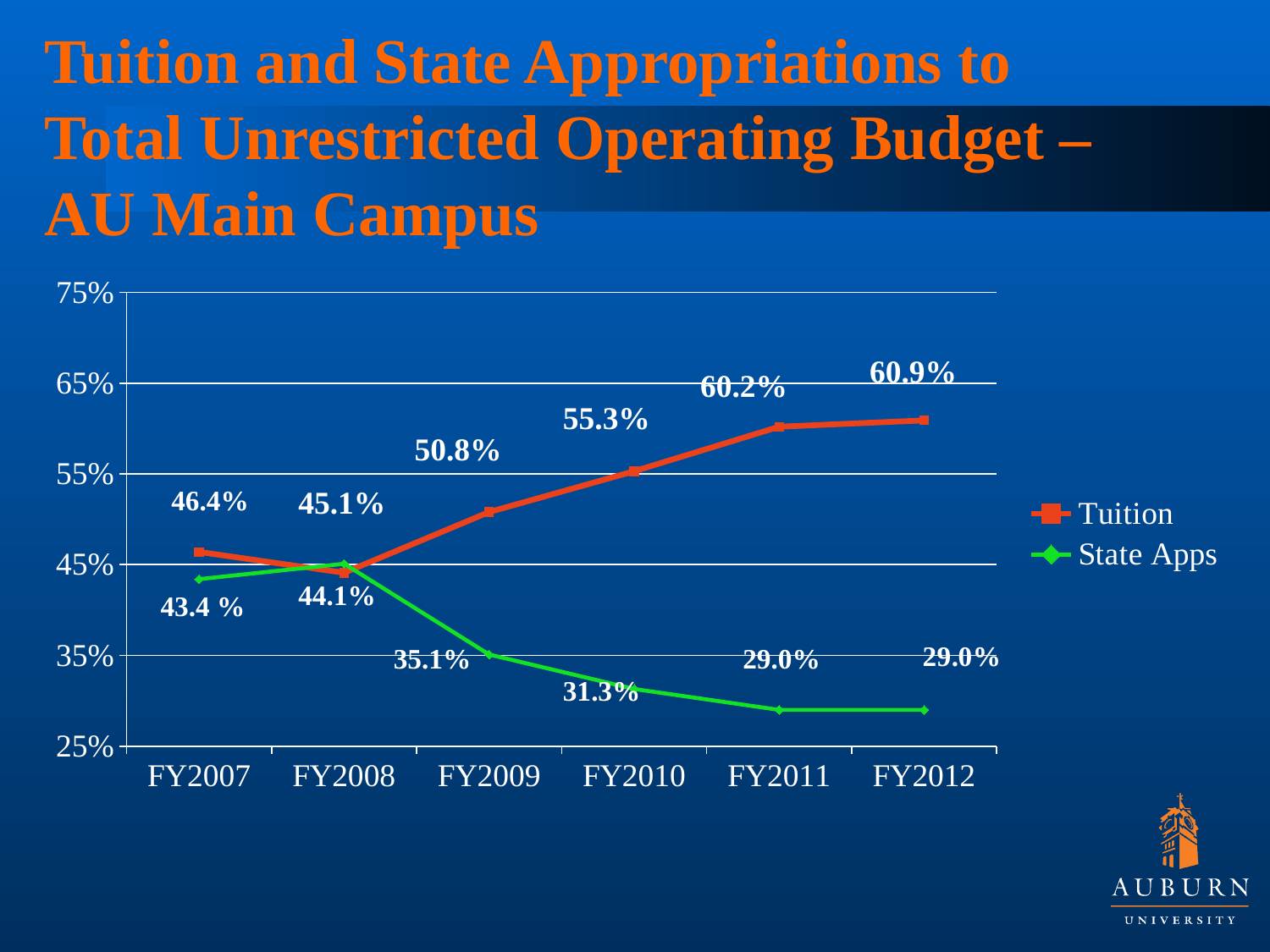
In which fiscal year is the State Apps series at its highest? FY2008 What kind of chart is shown on the slide? line chart What is the State Apps value for FY2007? 43.4 % What is the difference between the Tuition value and the State Apps value in FY2012? 31.9% How many fiscal years are shown on the x axis? 6 What is the State Apps value for FY2010? 31.3% What is the Tuition value for FY2012? 60.9% Does the State Apps series generally rise or fall from FY2008 to FY2012? fall In which fiscal year is the Tuition series at its lowest? FY2008 Which is larger in FY2009, Tuition or State Apps? Tuition Is the State Apps value for FY2011 greater or less than 35%? less How many series does the legend list? 2